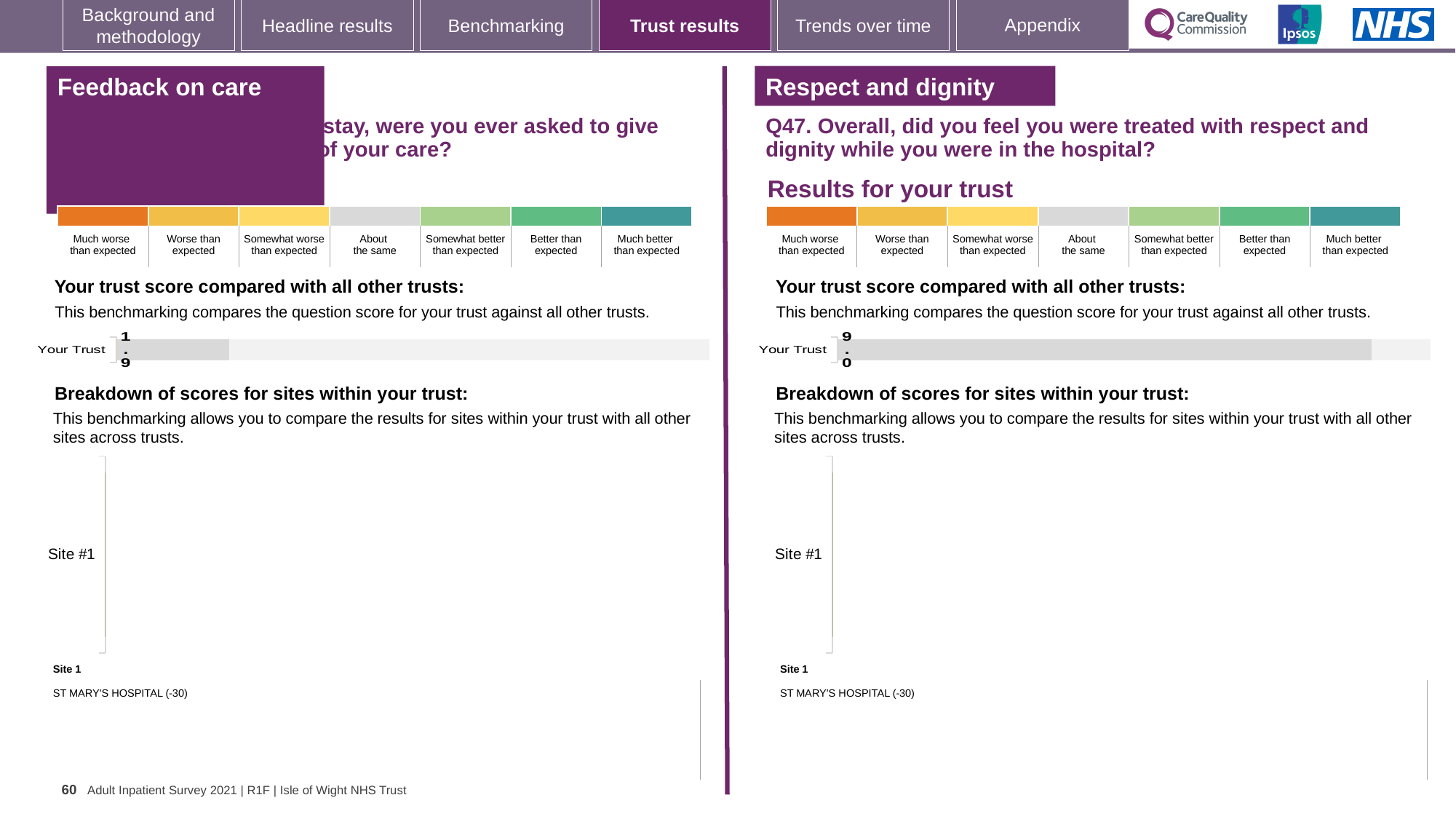
How many sites are listed in the 'Breakdown of scores for sites within your trust' chart on the 'Respect and dignity' side? 1 What is the label of the single category on the 'Your trust score compared with all other trusts' chart on the 'Feedback on care' side? Your Trust On the 'Respect and dignity' chart on the right, what is the score shown for Your Trust? 9.0 How many categories are plotted on the 'Your trust score compared with all other trusts' chart on the 'Respect and dignity' side? 1 Which hospital is listed as Site 1 under the 'Breakdown of scores for sites within your trust' chart on the 'Feedback on care' side? ST MARY'S HOSPITAL (-30) On the 'Feedback on care' chart on the left, what is the score shown for Your Trust? 1.9 What kind of chart is used to show the Your Trust score on the 'Feedback on care' side of the slide? Bar chart What is the difference between the Your Trust score on the 'Respect and dignity' chart (9.0) and the Your Trust score on the 'Feedback on care' chart (1.9)? 7.1 Which is larger: the Your Trust score on the 'Feedback on care' chart or the Your Trust score on the 'Respect and dignity' chart? Respect and dignity